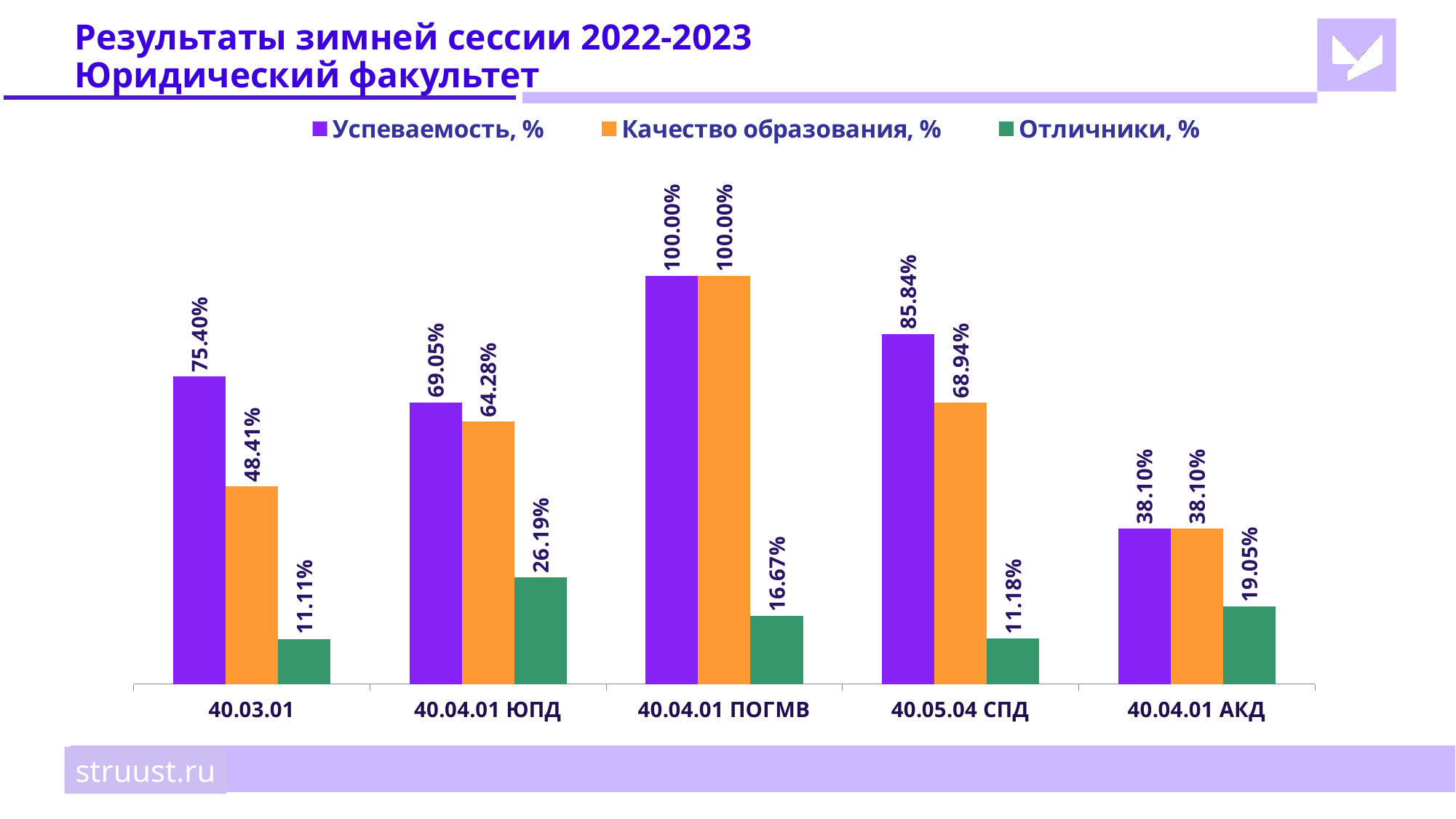
Which category has the lowest value of Успеваемость, %? 40.04.01 АКД How many categories are shown on the x axis? 5 Which is larger: Качество образования, % for 40.04.01 ЮПД or for 40.05.04 СПД? 40.05.04 СПД What is the value of Отличники, % for 40.04.01 АКД? 19.05% What is the value of Качество образования, % for 40.05.04 СПД? 68.94% How many series does the legend list? 3 What is the difference between Успеваемость, % and Отличники, % for 40.04.01 ПОГМВ? 83.33% What is the value of Успеваемость, % for 40.03.01? 75.40% What kind of chart is shown on the slide? Bar chart Which series is shown in green? Отличники, % Which category has the highest value of Отличники, %? 40.04.01 ЮПД What is the difference between Успеваемость, % and Качество образования, % for 40.03.01? 26.99%